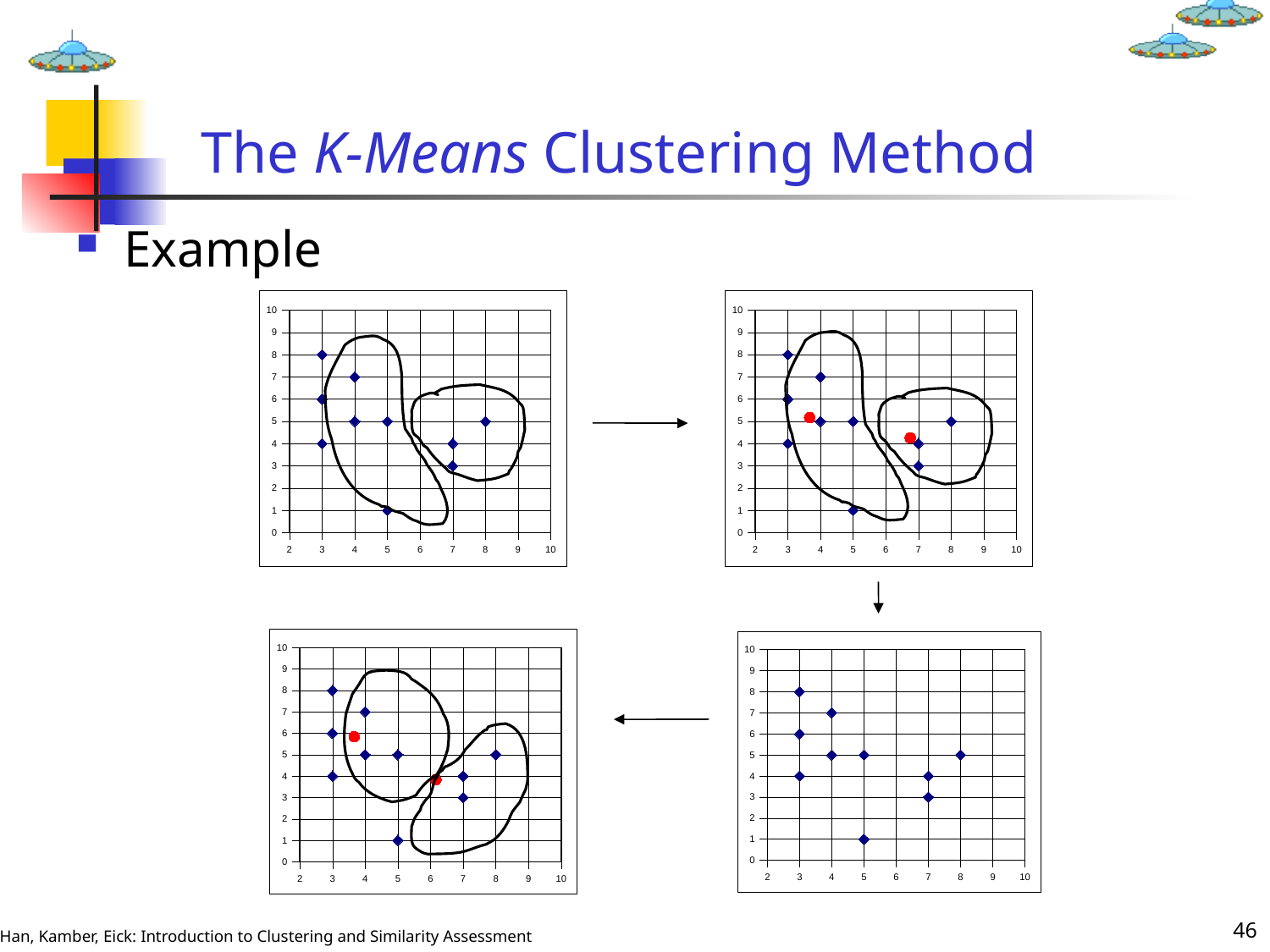
In the top-left chart, which point has a larger y value: the point at x=4 near the top or the point at x=8? the point at x=4 (y=7) In the bottom-right chart, what is the highest y value among the plotted points? 8 What kind of chart is the top-left chart on the slide? scatter chart What is the maximum value shown on the y axis of the top-right chart? 10 In the bottom-right chart, what is the largest x value among the plotted points? 8 How many blue data points are plotted in the bottom-right chart? 10 How many red centroid markers are shown in the bottom-left chart? 2 In the bottom-right chart, what is the x value of the point with y equal to 8? 3 In the bottom-right chart, what is the difference in y between the highest point and the lowest point? 7 How many charts are shown on the slide? 4 In the bottom-right chart, what is the x value of the point with y equal to 1? 5 In the bottom-right chart, what is the lowest y value among the plotted points? 1